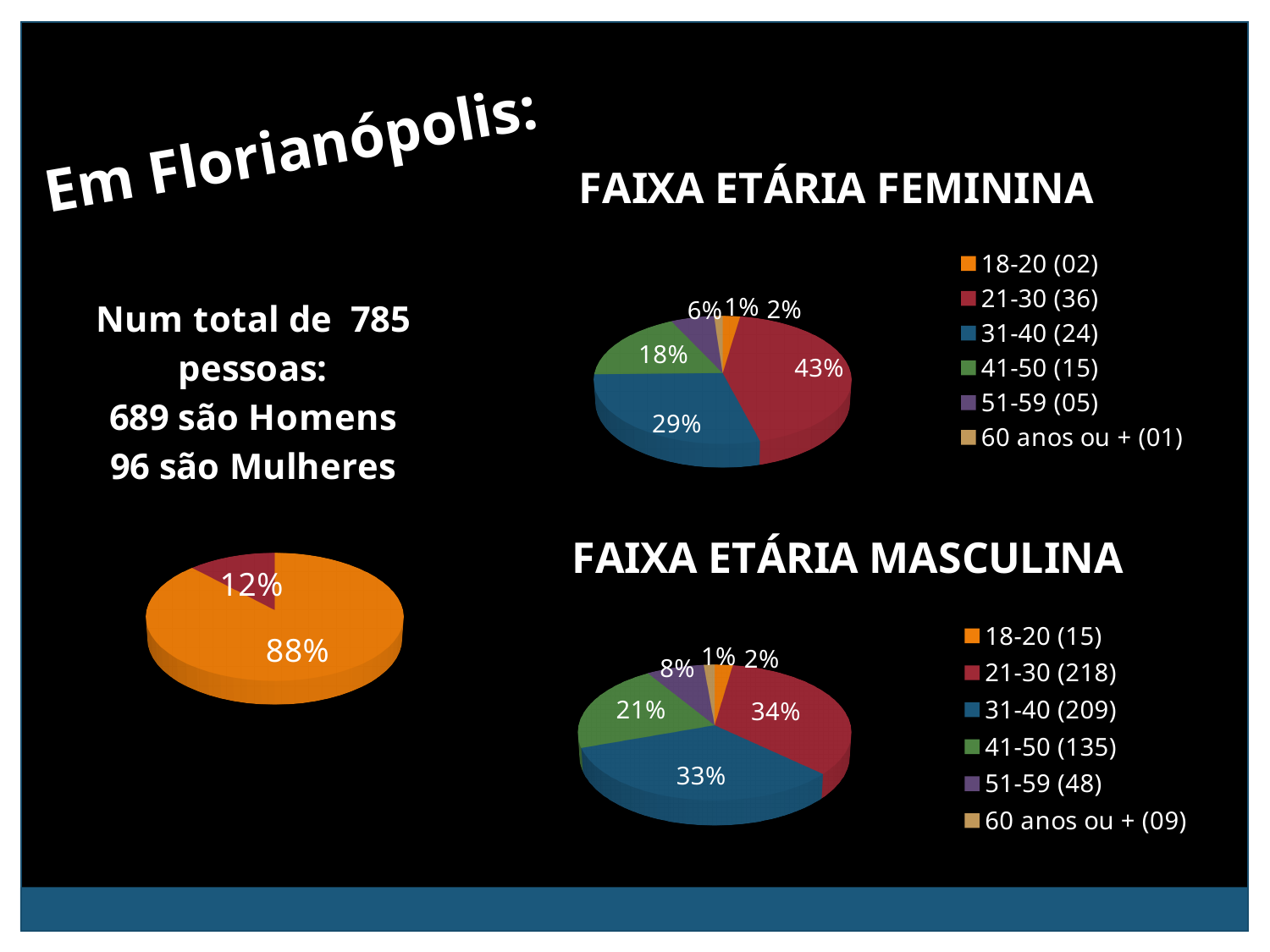
In the FAIXA ETÁRIA FEMININA chart, what percentage is shown for the 21-30 age group? 43% In the FAIXA ETÁRIA FEMININA chart, what count is shown in the legend for the 41-50 age group? 15 In the FAIXA ETÁRIA MASCULINA chart, which slice is larger, 51-59 or 41-50? 41-50 In the bottom-left pie chart, what percentage is shown for the larger (orange) slice? 88% In the FAIXA ETÁRIA FEMININA chart, which age group has the largest share? 21-30 In the FAIXA ETÁRIA MASCULINA chart, what percentage is shown for the 41-50 age group? 21% What kind of chart is used in the bottom-left of the slide? Pie chart In the FAIXA ETÁRIA MASCULINA chart, which age group has the smallest share? 60 anos ou + In the FAIXA ETÁRIA FEMININA chart, how many entries does the legend list? 6 In the FAIXA ETÁRIA FEMININA chart, what percentage is shown for the 31-40 age group? 29% In the FAIXA ETÁRIA MASCULINA chart, what is the difference in percentage points between the 21-30 and 31-40 slices? 1 In the FAIXA ETÁRIA MASCULINA chart, what count is shown in the legend for the 21-30 age group? 218